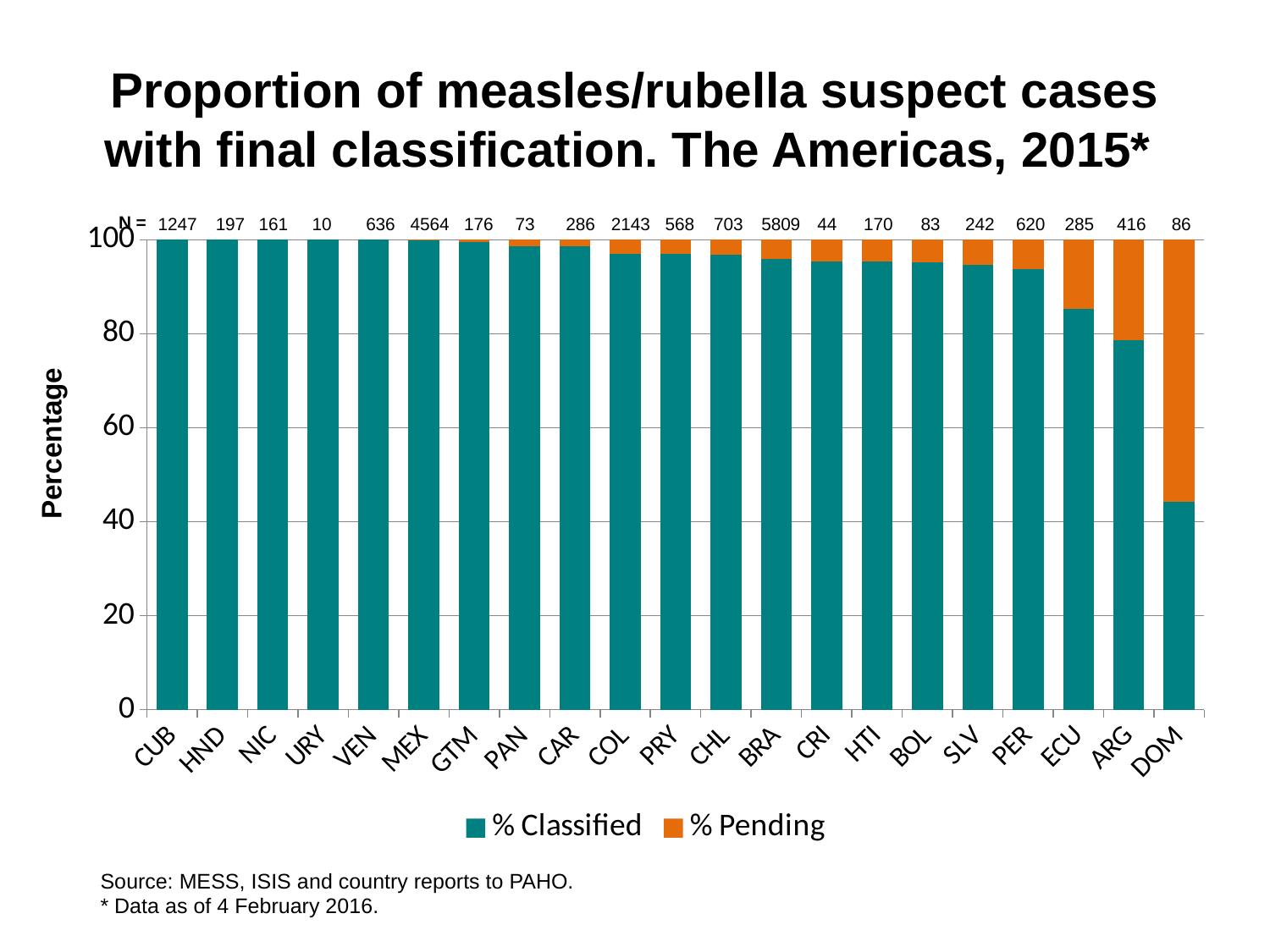
What is the difference between the N values printed for BRA and MEX? 1245 Which country has the smallest N value printed above its bar? URY How many series does the legend list? 2 Does the % Classified value generally rise or fall moving from left to right along the x axis? fall Which country has the largest N value printed above its bar? BRA Is the % Classified value for ECU greater or less than 80? greater How many countries/categories are shown on the x axis? 21 What kind of chart is shown on the slide? Stacked bar chart What is the N value printed above the bar for URY? 10 Is the % Classified value for DOM greater or less than 60? less Which has a larger printed N value, COL or CUB? COL What is the N value printed above the bar for BRA? 5809